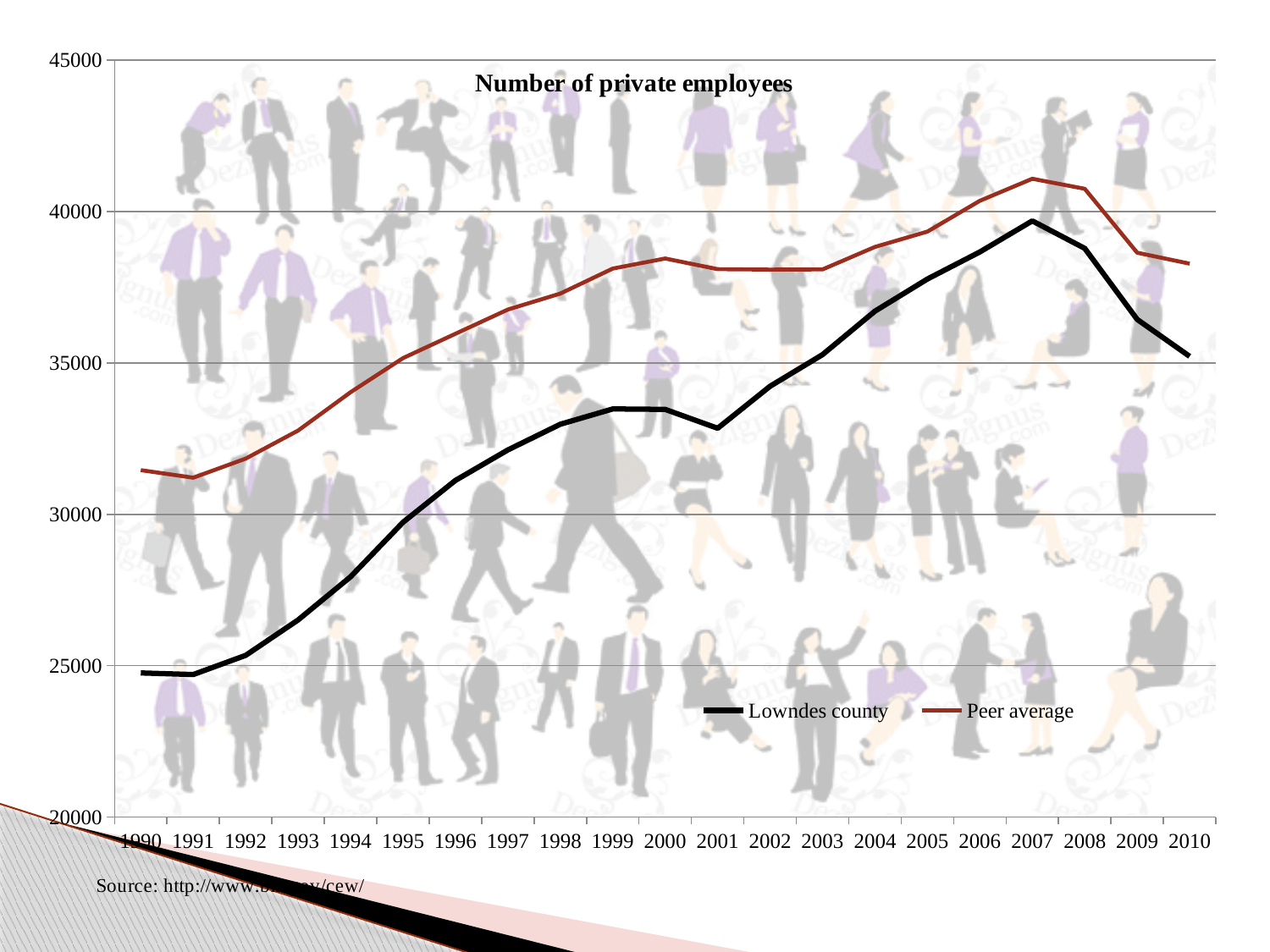
How many series does the legend list? 2 In 2000, which series has the higher value, Lowndes county or Peer average? Peer average Which series is drawn with the black line? Lowndes county Is the value for Peer average in 2007 greater or less than 40000? greater In which year does the Peer average series reach its highest value? 2007 In which year does the Lowndes county series reach its highest value? 2007 Is the value for Lowndes county in 1990 greater or less than 30000? less What is the title of the chart? Number of private employees Does the Lowndes county series rise or fall from 2007 to 2010? fall Is the value for Lowndes county in 2001 greater or less than 30000? greater What kind of chart is shown on the slide? line chart How many years are plotted along the x axis? 21